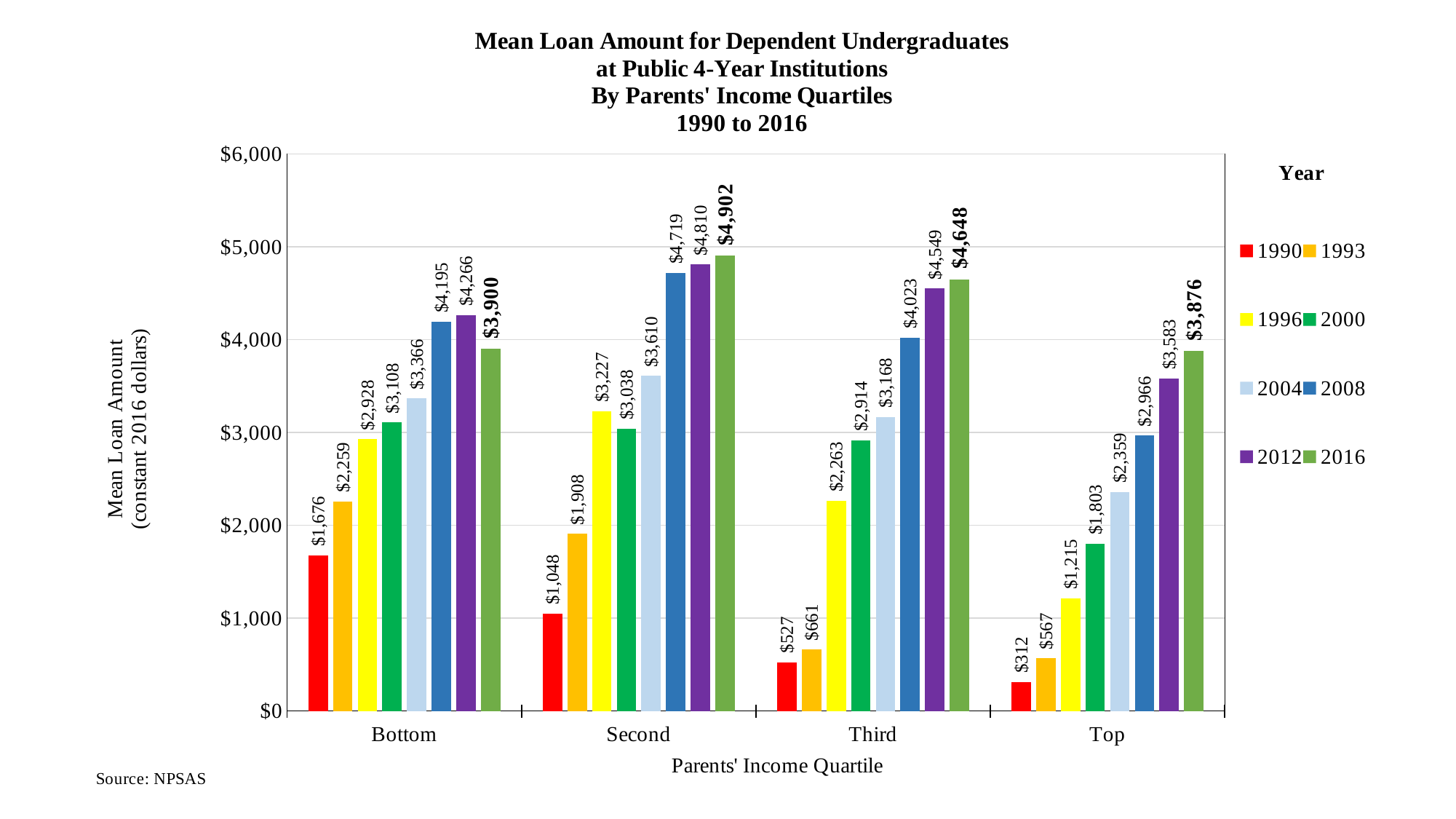
What is the mean loan amount for the Top income quartile in 1990? $312 What kind of chart is shown on the slide? bar chart How many parents' income quartiles are shown on the x axis? 4 Which parents' income quartile has the highest mean loan amount in 2016? Second What is the mean loan amount for the Bottom income quartile in 2016? $3,900 Is the 2004 mean loan amount for the Top quartile greater or less than $2,000? greater For the Top quartile, do the mean loan amounts rise or fall from 1990 to 2016? rise What is the label on the vertical axis of the chart? Mean Loan Amount (constant 2016 dollars) Which parents' income quartile has the lowest mean loan amount in 1990? Top How many years does the legend list? 8 For the Bottom quartile, which year has the larger mean loan amount, 2012 or 2016? 2012 What is the difference between the 2016 mean loan amount for the Second quartile and the Bottom quartile? $1,002